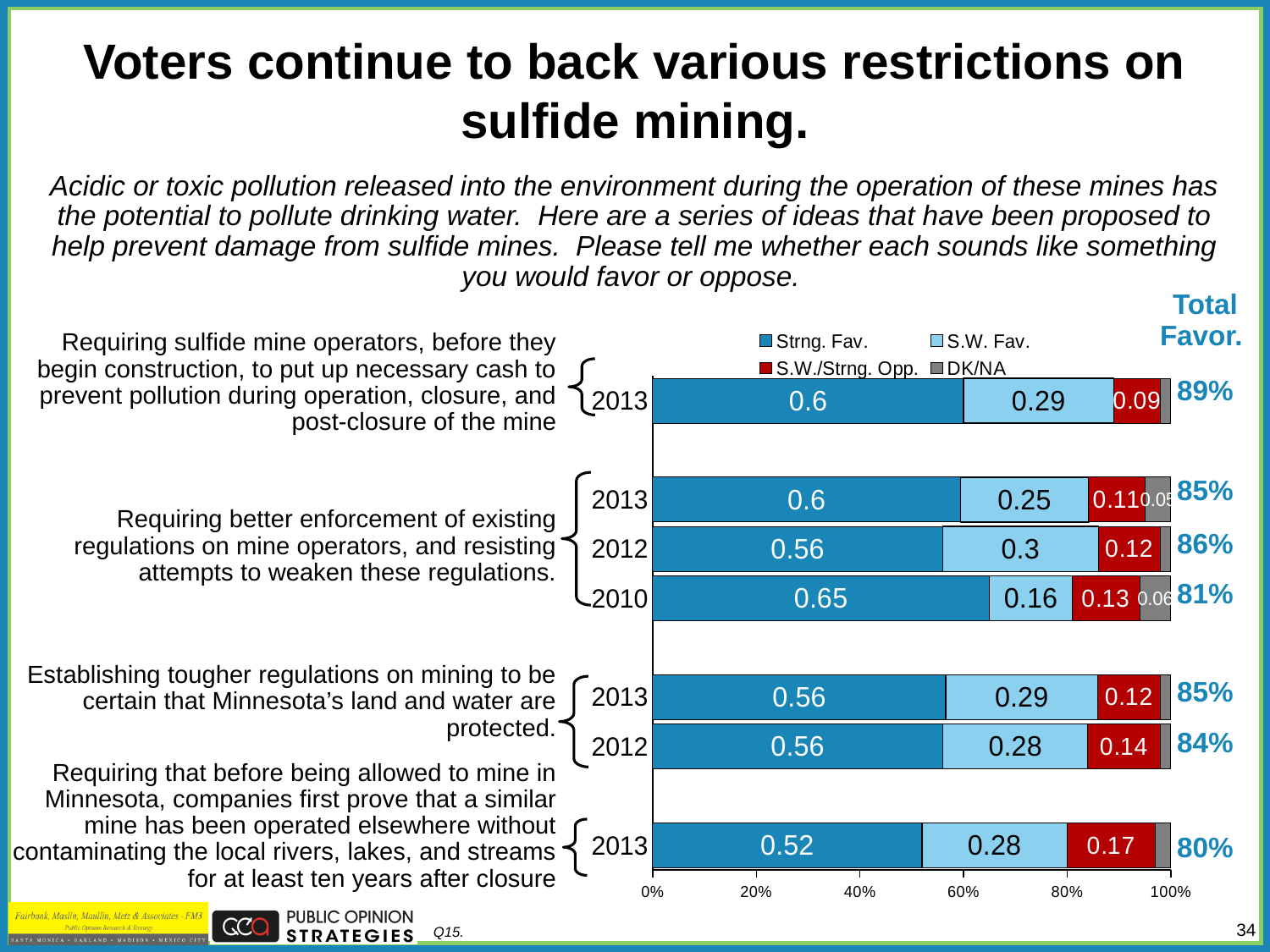
What is the DK/NA value for the 2013 bar under "Requiring better enforcement of existing regulations on mine operators"? 0.05 What is the Total Favor percentage shown for the 2013 bar under "Requiring sulfide mine operators, before they begin construction, to put up necessary cash"? 89% How many series does the legend list? 4 Which bar has the highest Strng. Fav. value? 2010, Requiring better enforcement of existing regulations What is the S.W./Strng. Opp. value for the 2013 bar under "Requiring that before being allowed to mine in Minnesota, companies first prove that a similar mine has been operated elsewhere"? 0.17 What is the S.W. Fav. value for the 2013 bar under "Requiring sulfide mine operators, before they begin construction, to put up necessary cash"? 0.29 What is the Strng. Fav. value for the 2010 bar under "Requiring better enforcement of existing regulations on mine operators"? 0.65 Under "Requiring better enforcement of existing regulations", what is the difference between the Strng. Fav. values for 2010 and 2012? 0.09 What kind of chart is shown on the slide? Stacked bar chart Under "Requiring better enforcement of existing regulations", which year has the larger S.W. Fav. value, 2012 or 2013? 2012 How many bars are plotted in the chart? 7 Which bar has the lowest Strng. Fav. value? 2013, Requiring that companies first prove a similar mine has been operated elsewhere